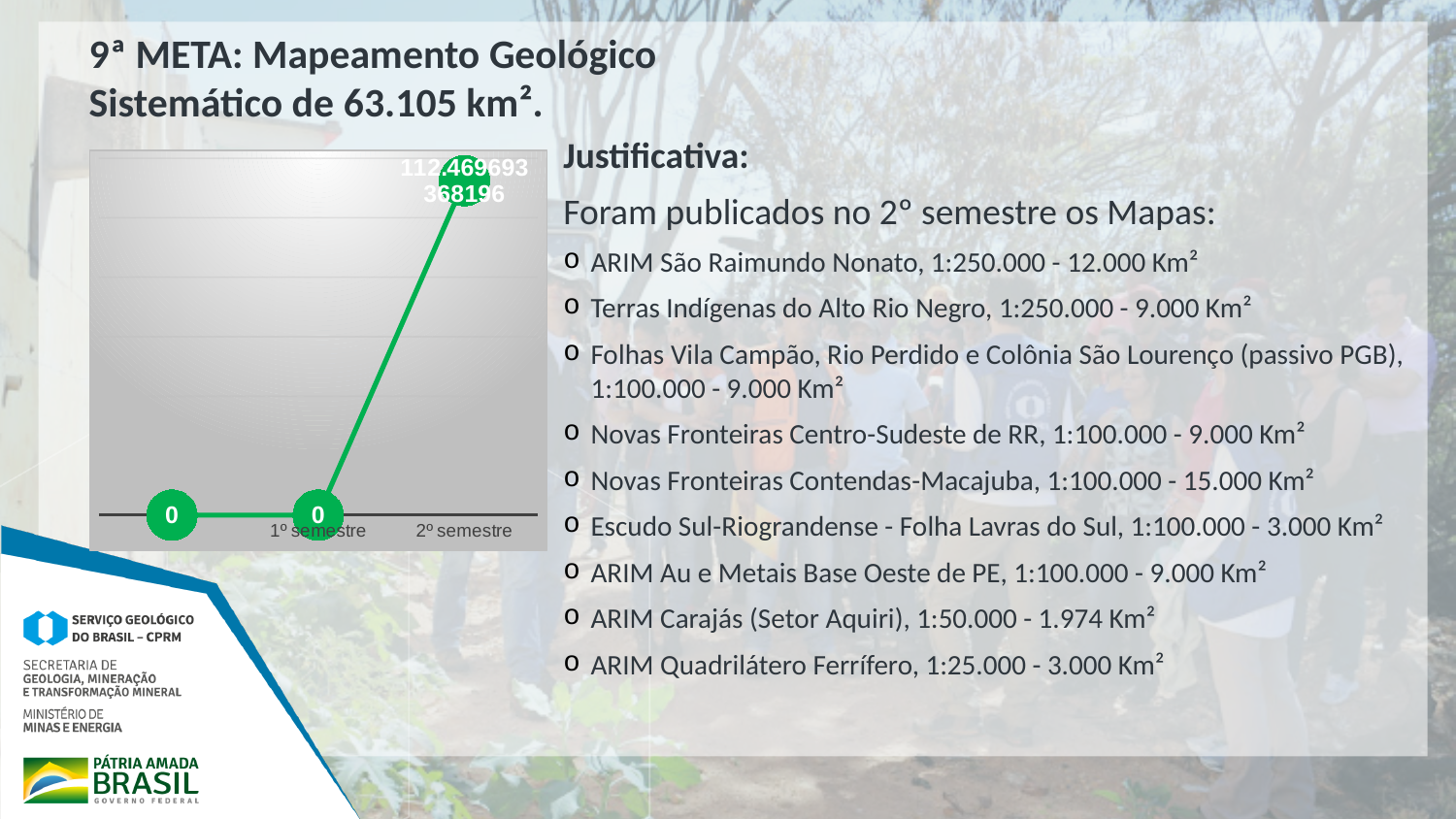
How many categories are shown on the x axis of the chart? 2 What is the value plotted for 1º semestre in the chart? 0 What are the two category labels on the x axis of the chart? 1º semestre and 2º semestre Does the line in the chart rise or fall from 1º semestre to 2º semestre? rise What colour is the line in the chart? green Which category has the highest value in the chart? 2º semestre What kind of chart is shown on the slide? line chart Which category has the higher value in the chart, 1º semestre or 2º semestre? 2º semestre